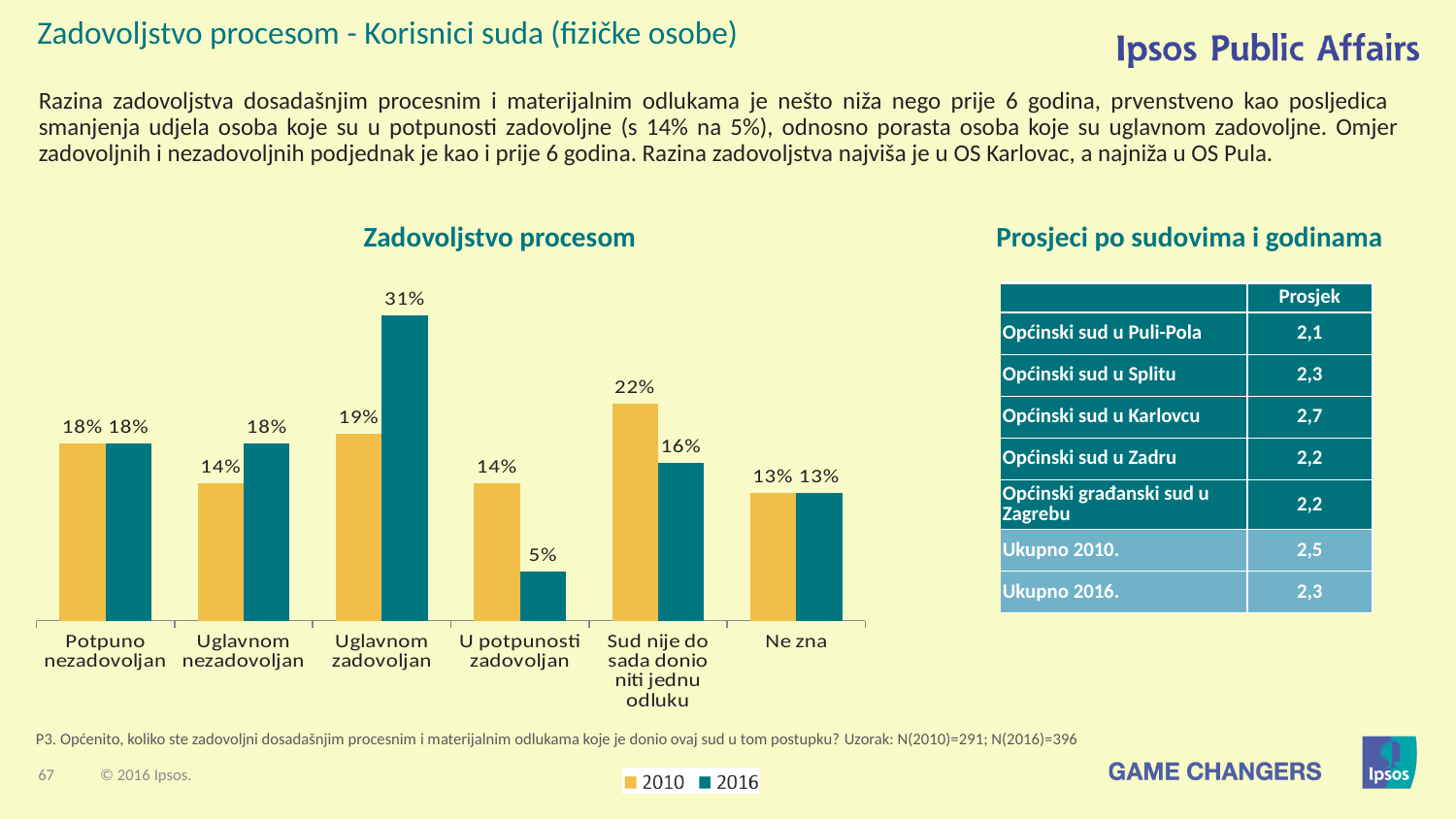
What is the difference between the 2010 and 2016 values for "U potpunosti zadovoljan"? 9% How many categories are shown on the x axis of the chart? 6 What is the 2016 value for "Uglavnom zadovoljan"? 31% Which category has the highest 2016 value? Uglavnom zadovoljan What is the 2010 value for "Uglavnom nezadovoljan"? 14% Which category has the lowest 2016 value? U potpunosti zadovoljan What is the 2016 value for "U potpunosti zadovoljan"? 5% How many series does the chart legend list? 2 What is the 2010 value for "Sud nije do sada donio niti jednu odluku"? 22% For "Sud nije do sada donio niti jednu odluku", which year has the larger value, 2010 or 2016? 2010 Which category has the lowest 2010 value? Ne zna What is the difference between the 2016 and 2010 values for "Uglavnom zadovoljan"? 12%